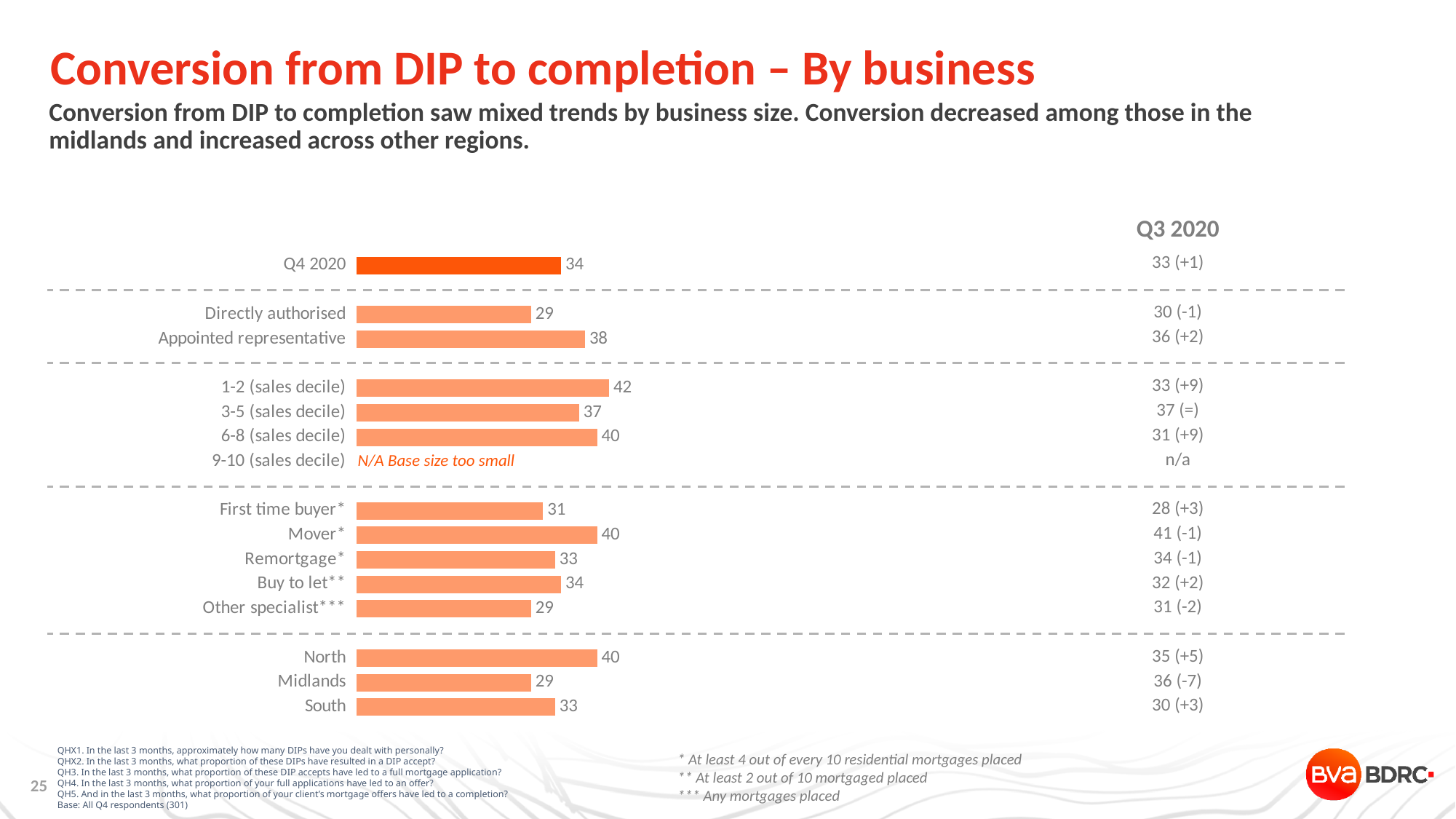
What is the value for 6-8 (sales decile)? 40 What is the value for Midlands? 29 What is the value for Appointed representative? 38 Among the three regions (North, Midlands, South), which has the lowest value? Midlands What is the difference between the values for Appointed representative and Directly authorised? 9 What kind of chart is shown on the slide? bar chart What is the difference between the values for North and South? 7 What is the value for Q4 2020 overall? 34 What is shown for the 9-10 (sales decile) category instead of a bar? N/A Base size too small Which category has the highest value on the chart? 1-2 (sales decile) How many region categories are shown on the chart? 3 Which is larger, the value for Mover* or the value for First time buyer*? Mover*